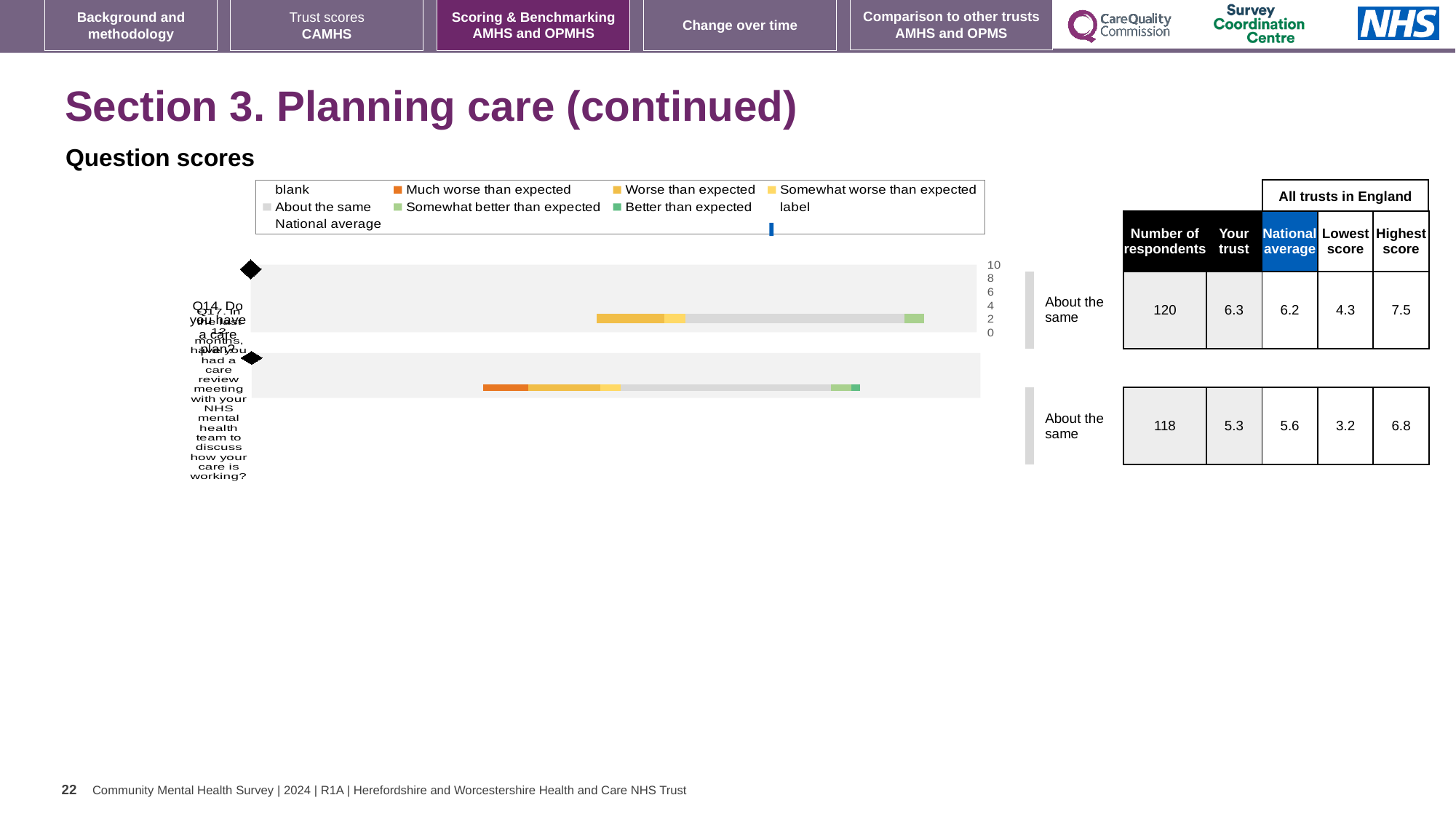
What is the 'Your trust' score for Q17 in the table beside the chart? 5.3 What kind of chart is shown under 'Question scores'? bar chart For Q14, which is larger: the 'Your trust' score or the national average? Your trust What benchmark category is shown next to the Q17 bar? About the same Which question has the higher national average, Q14 or Q17? Q14 How many questions (bars) are plotted in the chart? 2 According to the table beside the chart, how many respondents answered Q14? 120 By how much does the 'Your trust' score for Q14 exceed the national average? 0.1 In the chart legend, what colour represents 'Much worse than expected'? orange What is the lowest score across all trusts in England for Q17? 3.2 What is the difference between the highest score and the lowest score for Q17? 3.6 What is the highest score across all trusts in England for Q14? 7.5